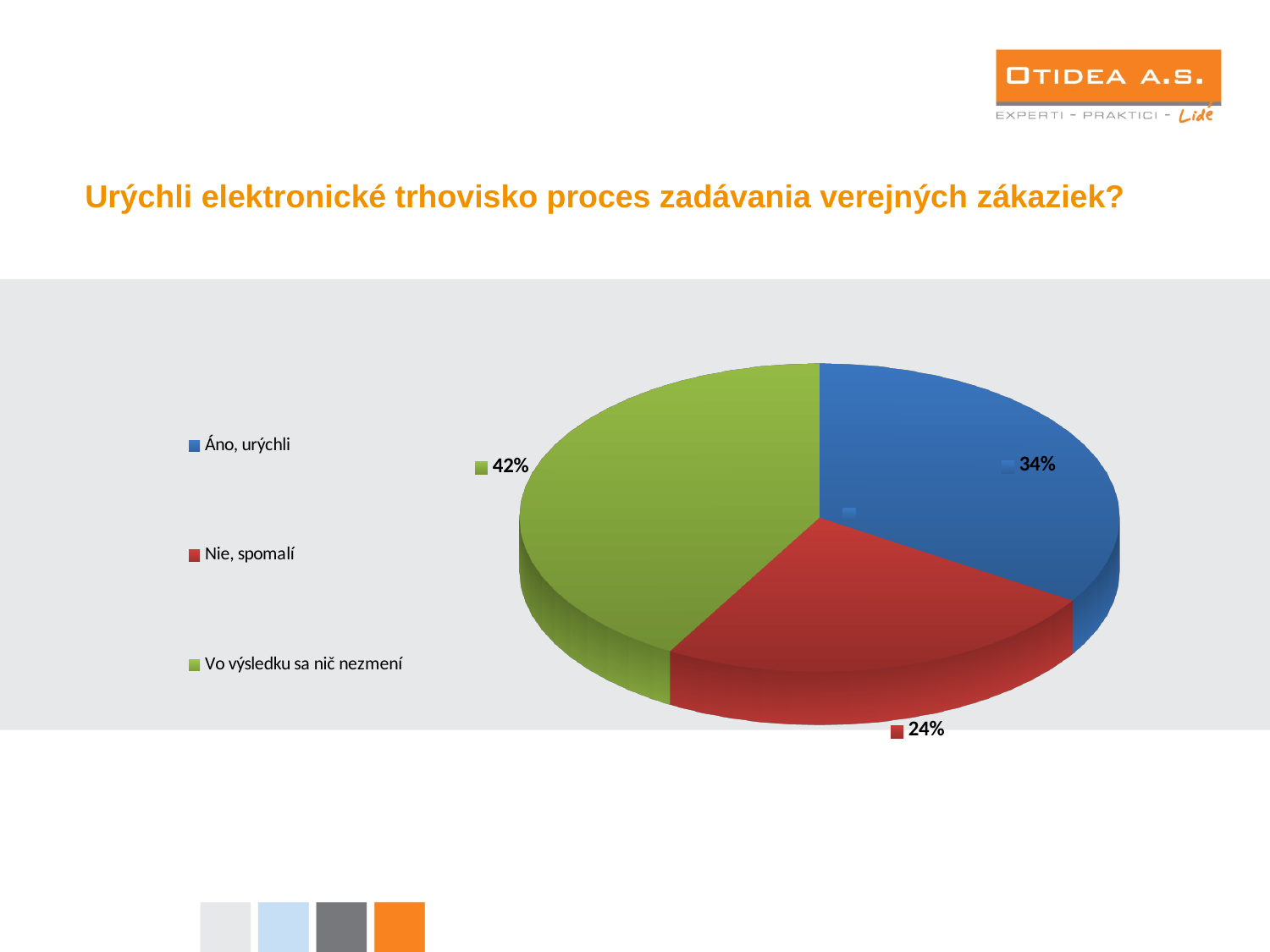
What is the difference in percentage points between "Áno, urýchli" and "Nie, spomalí"? 10 What percentage of respondents answered "Nie, spomalí"? 24% What colour is the slice for "Nie, spomalí"? Red Which response has the largest share of the pie? Vo výsledku sa nič nezmení Which is larger: the share for "Áno, urýchli" or the share for "Nie, spomalí"? Áno, urýchli What percentage of respondents answered "Áno, urýchli"? 34% What percentage of respondents answered "Vo výsledku sa nič nezmení"? 42% Which response has the smallest share of the pie? Nie, spomalí How many slices does the pie chart have? 3 What kind of chart is shown on the slide? Pie chart What is the title of the chart on the slide? Urýchli elektronické trhovisko proces zadávania verejných zákaziek? What is the difference in percentage points between "Vo výsledku sa nič nezmení" and "Áno, urýchli"? 8